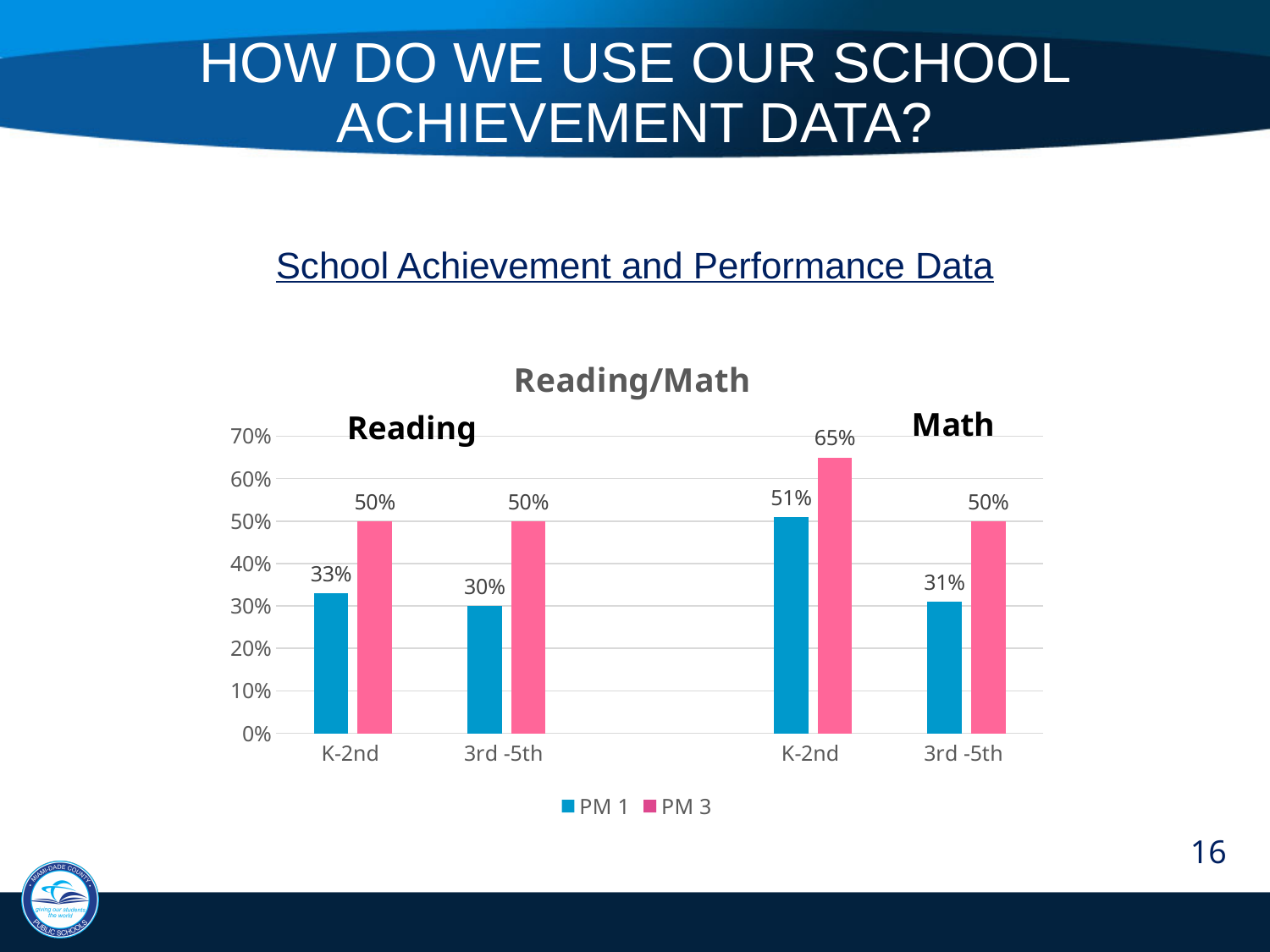
How many series does the legend list? 2 What is the PM 3 value for K-2nd in Math? 65% What is the PM 1 value for 3rd -5th in Math? 31% What kind of chart is shown on the slide? Bar chart What is the title of the chart? Reading/Math Which group and subject has the lowest PM 1 value? 3rd -5th Reading What is the difference between the PM 3 and PM 1 values for 3rd -5th in Reading? 20% Which is larger, the PM 1 value for K-2nd in Math or the PM 1 value for K-2nd in Reading? K-2nd Math What is the PM 1 value for K-2nd in Reading? 33% What is the PM 3 value for 3rd -5th in Reading? 50% Which group and subject has the highest PM 3 value? K-2nd Math What is the difference between the PM 3 and PM 1 values for K-2nd in Math? 14%